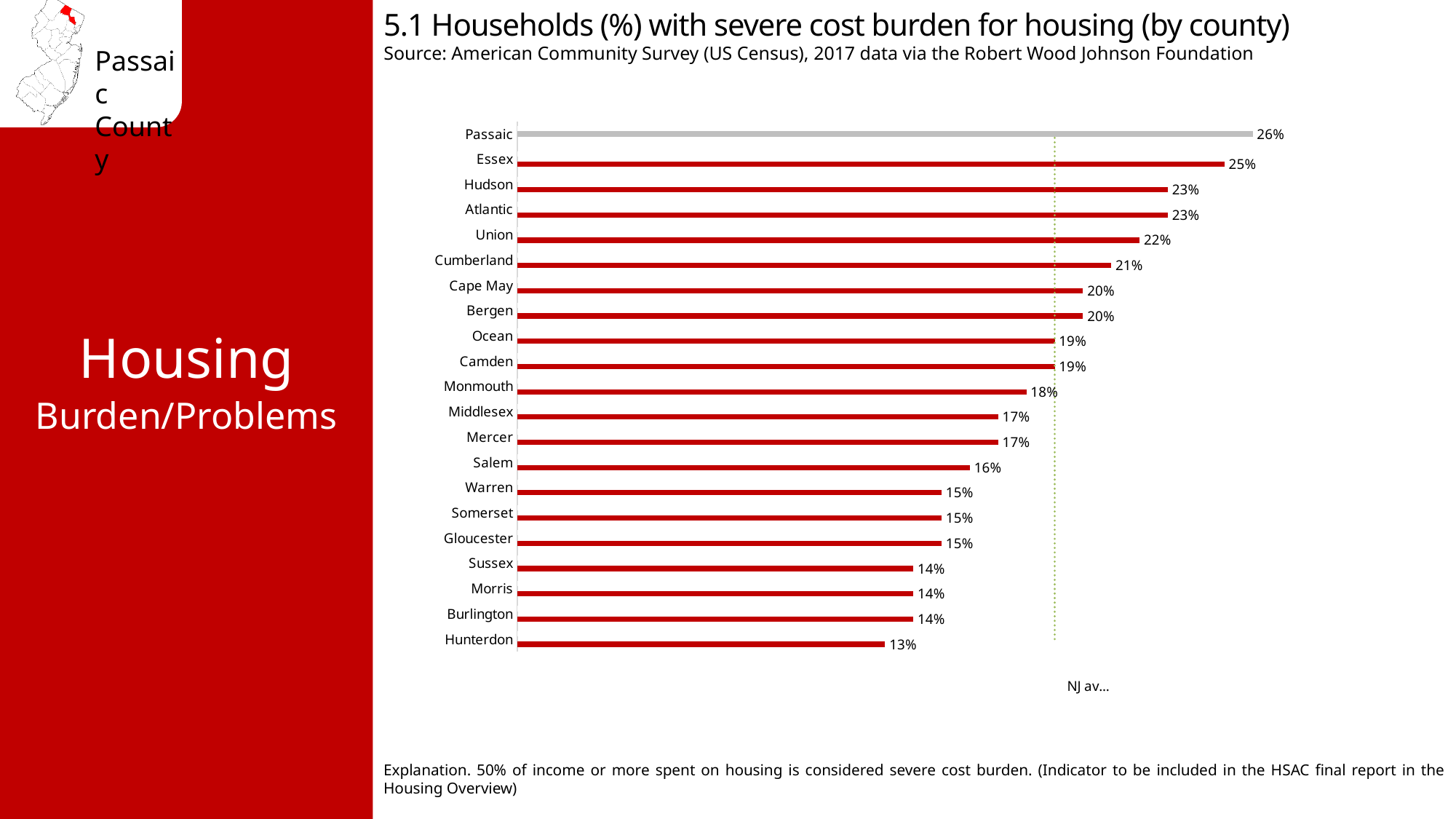
What is the value for Passaic? 26% What is the difference between the values for Passaic and Hunterdon? 13% Which is larger, the value for Hudson or the value for Bergen? Hudson What is the value for Hunterdon? 13% What is the value for Salem? 16% Which county has the lowest value? Hunterdon How many counties are shown in the chart? 21 What kind of chart is shown on the slide? Bar chart What is the value for Cumberland? 21% Which county has the highest value? Passaic What is the difference between the values for Essex and Union? 3% Which county's bar is coloured grey instead of red? Passaic